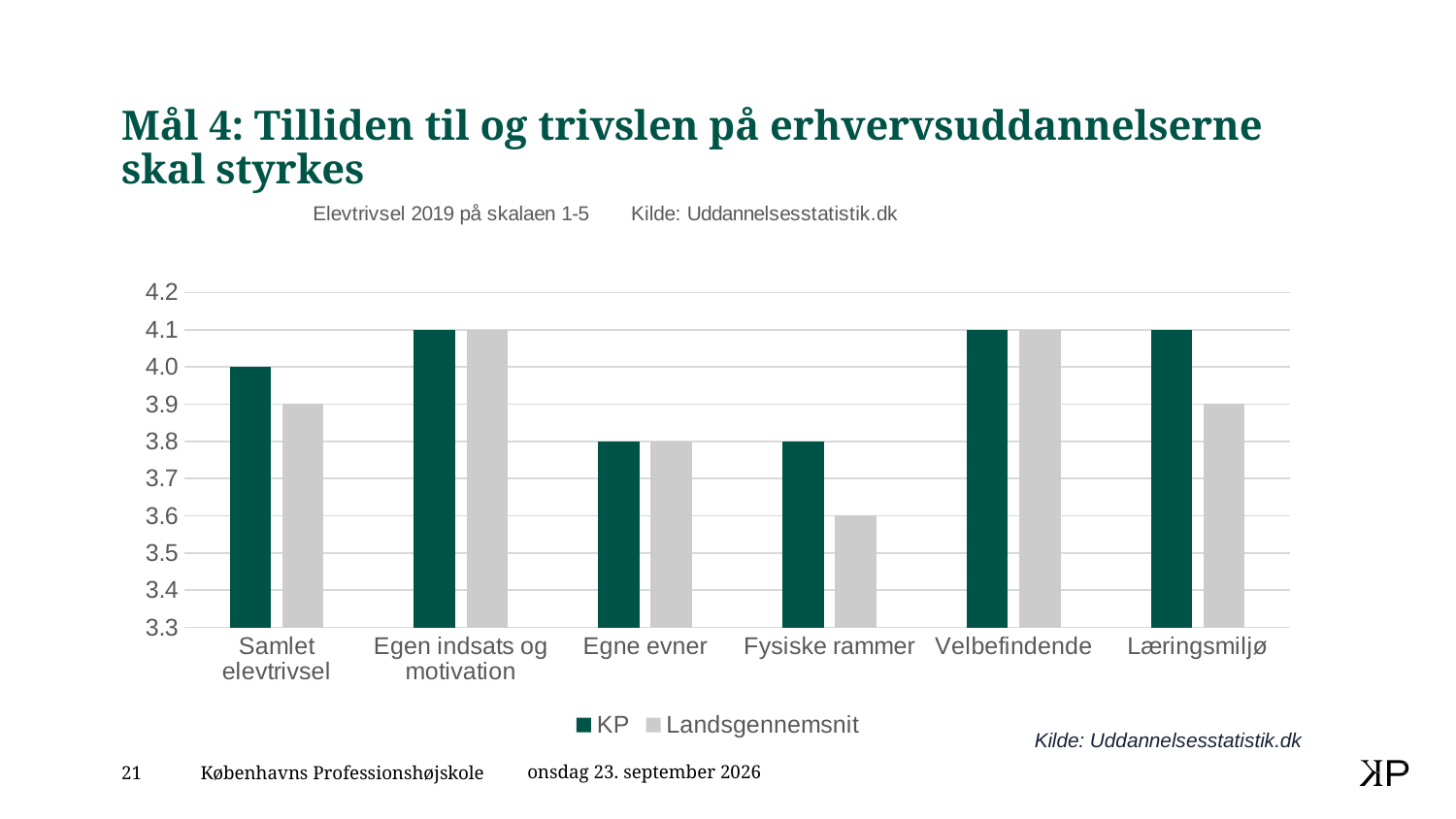
What is the Landsgennemsnit value for Fysiske rammer? 3.6 What is the difference between the KP and Landsgennemsnit values for Fysiske rammer? 0.2 What are the two series named in the legend? KP and Landsgennemsnit What is the source cited for the chart? Uddannelsesstatistik.dk Is the KP value for Egne evner greater or less than 4.0? less Which category has the lowest Landsgennemsnit value? Fysiske rammer Which is larger for Læringsmiljø, the KP value or the Landsgennemsnit value? KP How many categories are shown on the x axis? 6 What is the KP value for Samlet elevtrivsel? 4.0 What kind of chart is shown on the slide? bar chart How many series does the legend list? 2 What is the Landsgennemsnit value for Læringsmiljø? 3.9